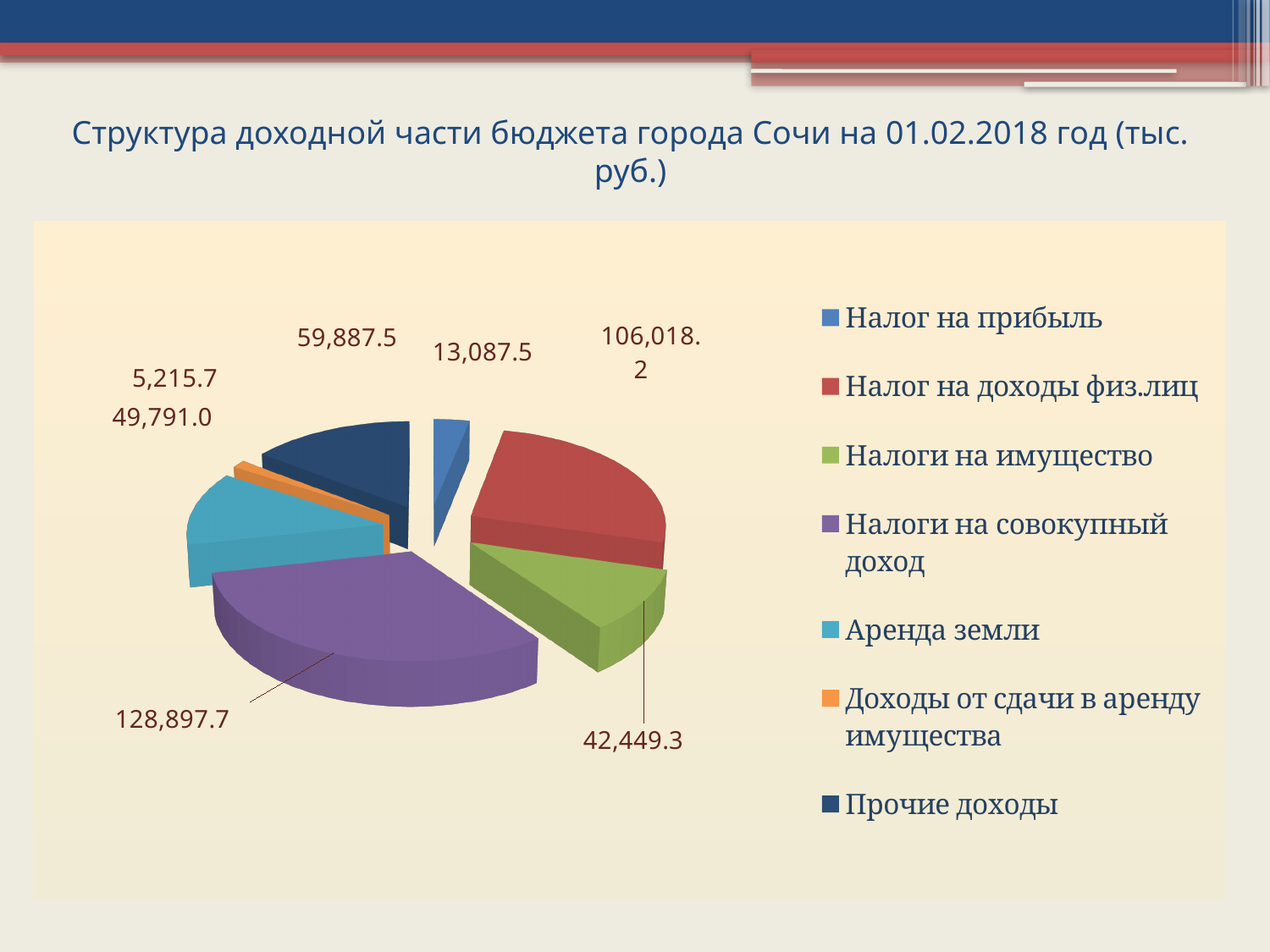
What is the value for Доходы от сдачи в аренду имущества? 5,215.7 What is the title of the chart on the slide? Структура доходной части бюджета города Сочи на 01.02.2018 год (тыс. руб.) What is the difference between Налоги на совокупный доход and Налог на доходы физ.лиц? 22,879.5 What kind of chart is shown on the slide? Pie chart What is the value for Налоги на совокупный доход? 128,897.7 Which category has the smallest value? Доходы от сдачи в аренду имущества What is the value for Аренда земли? 49,791.0 What is the difference between Прочие доходы and Аренда земли? 10,096.5 What is the value for Налог на доходы физ.лиц? 106,018.2 Which is larger, Прочие доходы or Налоги на имущество? Прочие доходы How many categories does the pie chart have? 7 Which category has the largest value? Налоги на совокупный доход